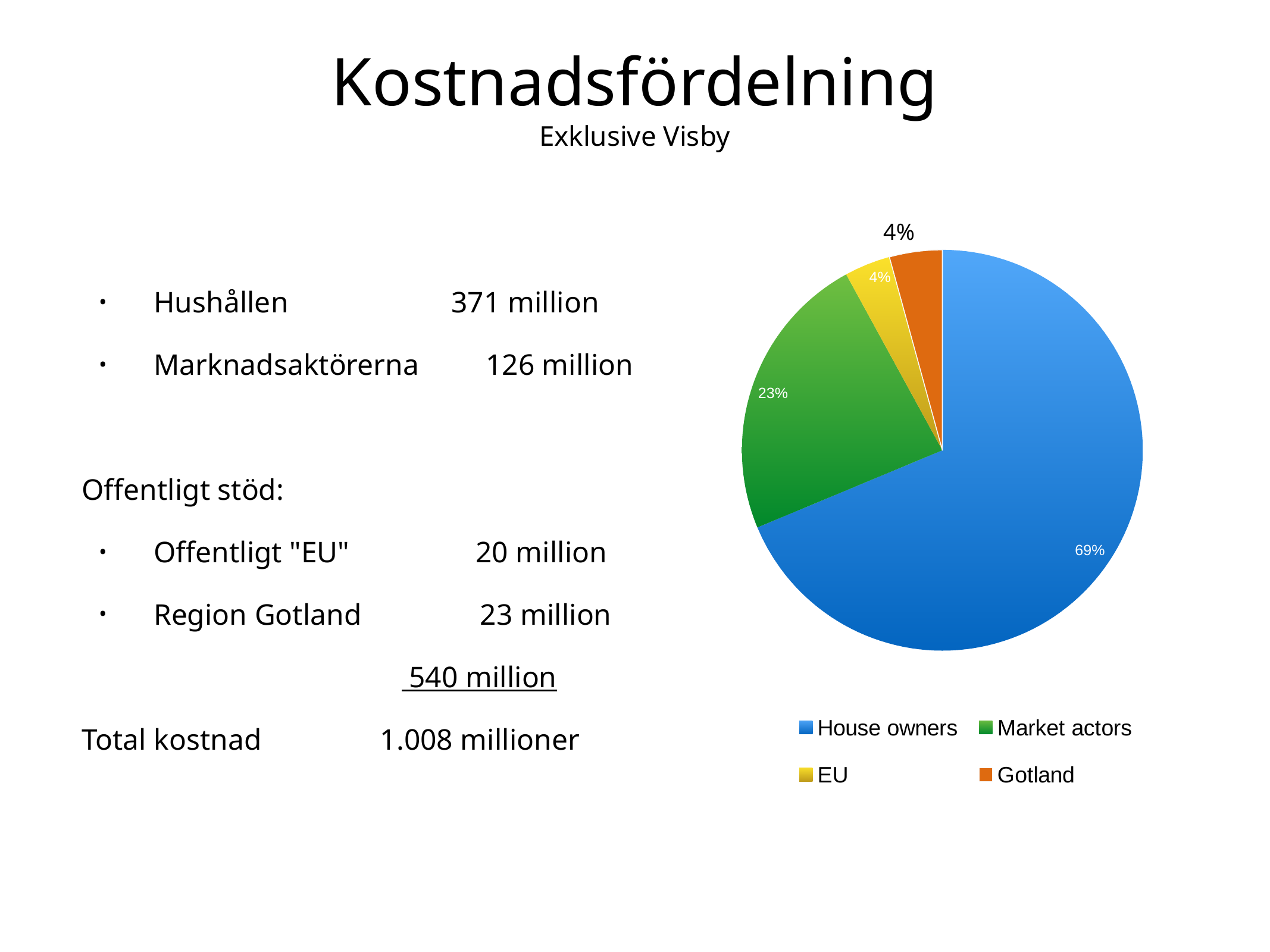
What is the difference in percentage points between the House owners slice and the Market actors slice? 46 How many entries does the legend of the pie chart list? 4 What percentage of the pie chart is Market actors? 23% What percentage of the pie chart is House owners? 69% How many slices does the pie chart have? 4 What colour is the Gotland slice in the pie chart? orange Which slice of the pie chart is the largest? House owners What percentage of the pie chart is Gotland? 4% What kind of chart is shown on the slide? pie chart What colour is the House owners slice in the pie chart? blue Which is larger in the pie chart, Market actors or House owners? House owners What percentage of the pie chart is EU? 4%